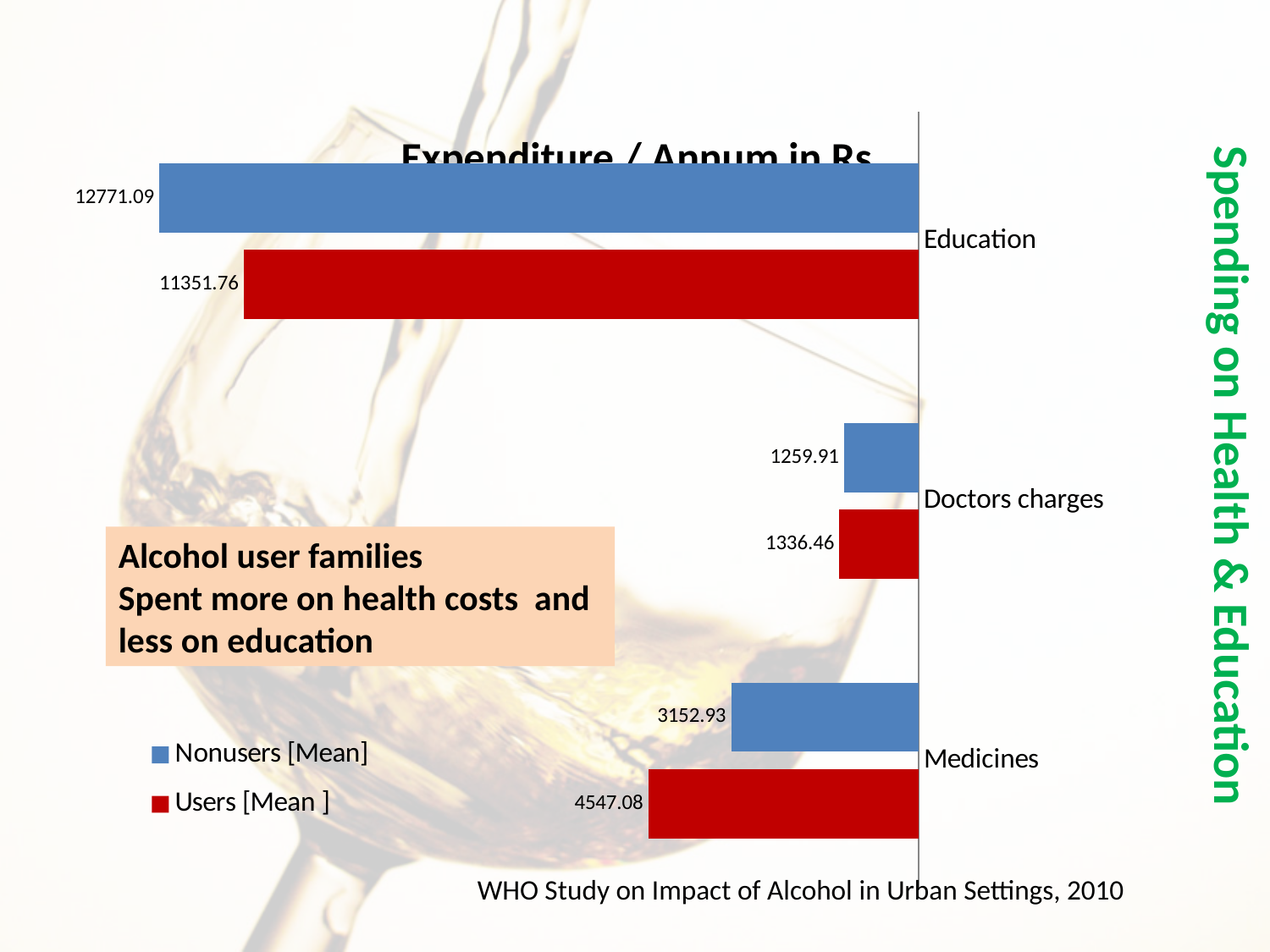
What is the value for Users [Mean ] in the Medicines category? 4547.08 In the Doctors charges category, which is larger: Users [Mean ] or Nonusers [Mean]? Users [Mean ] How many categories are shown in the chart? 3 What is the difference between Nonusers [Mean] and Users [Mean ] in the Education category? 1419.33 What is the value for Nonusers [Mean] in the Medicines category? 3152.93 What kind of chart is shown on the slide? Bar chart How many series does the legend list? 2 What is the difference between Users [Mean ] and Nonusers [Mean] in the Medicines category? 1394.15 What is the value for Nonusers [Mean] in the Education category? 12771.09 What is the value for Users [Mean ] in the Doctors charges category? 1336.46 Which category has the lowest value for Nonusers [Mean]? Doctors charges Which category has the highest value for Users [Mean ]? Education